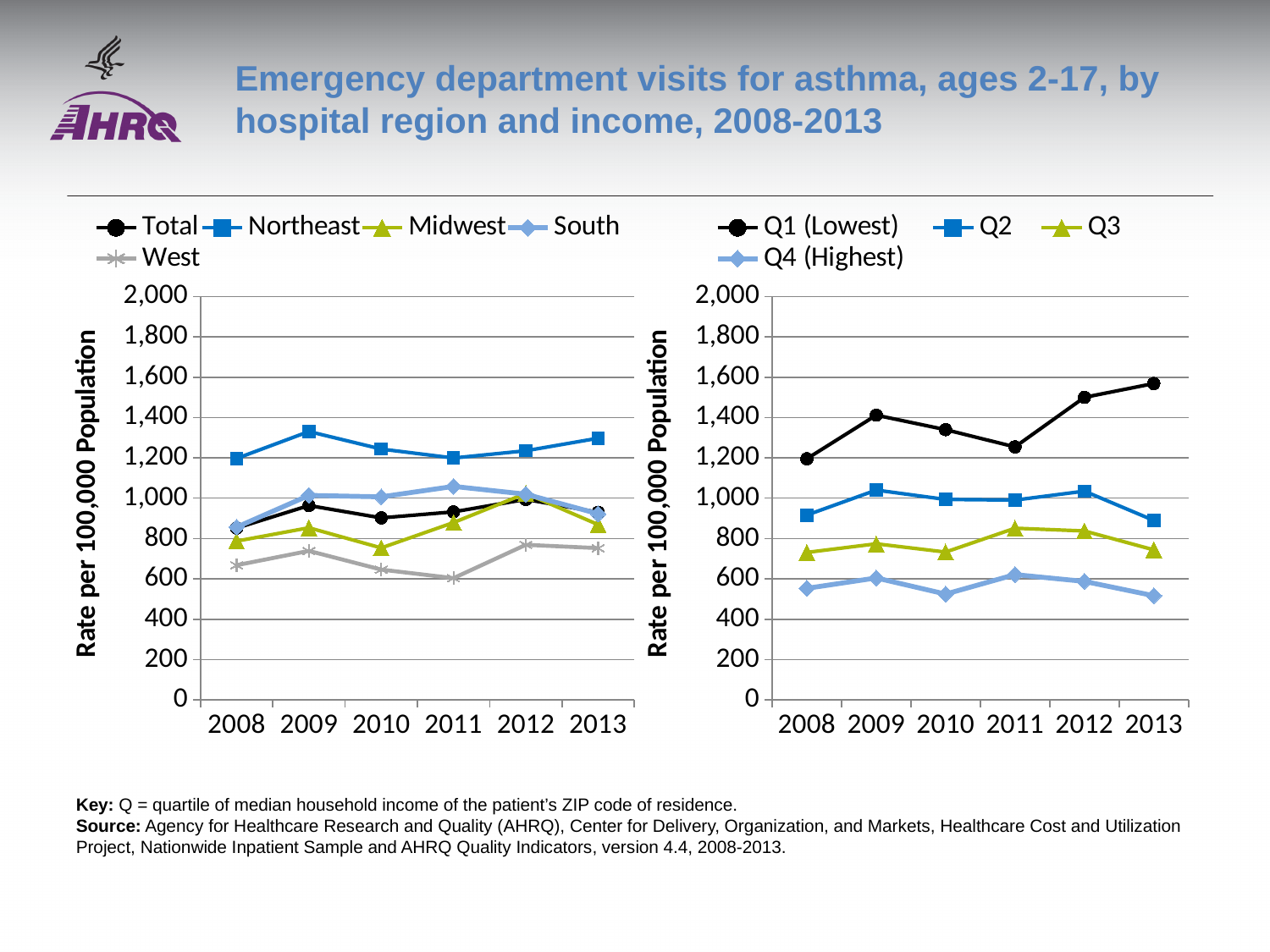
How many years are shown on the x axis of the right chart (Q1 to Q4)? 6 In the right chart (Q1 to Q4), is the value for Q1 (Lowest) in 2013 greater or less than 1,400? greater In the right chart (Q1 to Q4), which series has the highest rate in 2013? Q1 (Lowest) In the right chart (Q1 to Q4), does the Q1 (Lowest) series rise or fall overall from 2008 to 2013? Rise In the left chart (by hospital region), which series has the lowest rate in 2011? West In the left chart (by hospital region), is the value for West in 2011 greater or less than 800? less How many series does the legend of the left chart (by hospital region) list? 5 What kind of chart is the left chart (Total, Northeast, Midwest, South, West)? Line chart In the right chart (Q1 to Q4), which series has the lowest rate in 2010? Q4 (Highest) In the left chart (by hospital region), is the value for Northeast in 2009 greater or less than 1,200? greater In the left chart (by hospital region), which series has the highest rate in 2009? Northeast How many series does the legend of the right chart (Q1 to Q4) list? 4